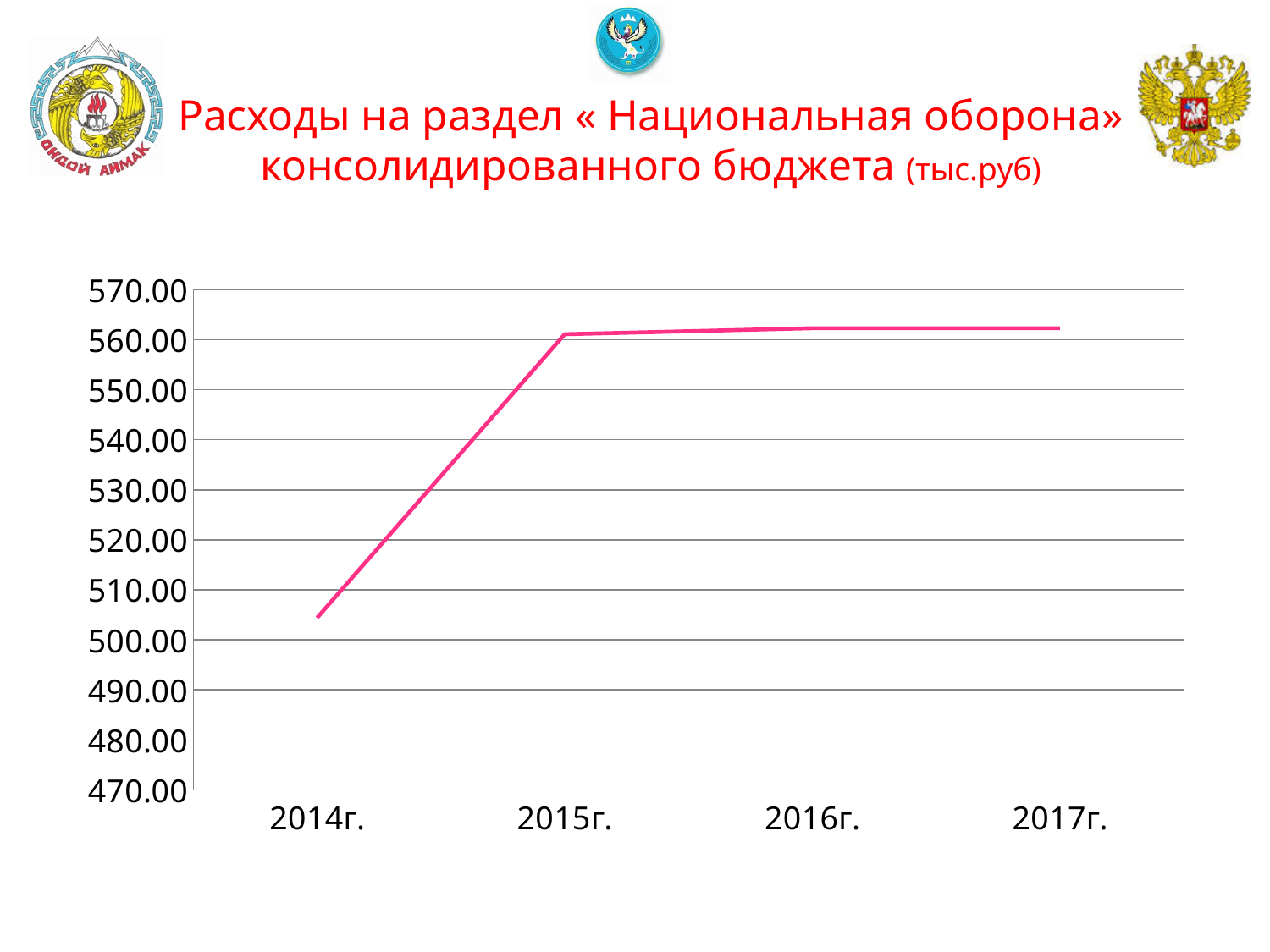
Is the value for 2017г. greater or less than 550? greater Do the values rise or fall from 2014г. to 2015г.? rise How many years are plotted on the x axis of the chart? 4 What unit is given in the chart title? тыс.руб Is the value for 2014г. greater or less than 510? less What kind of chart is shown on the slide? line chart Is the value for 2016г. greater or less than 570? less Which is larger, the value for 2014г. or the value for 2015г.? 2015г. Which year has the lowest value on the chart? 2014г. What is the lowest value shown on the vertical axis? 470.00